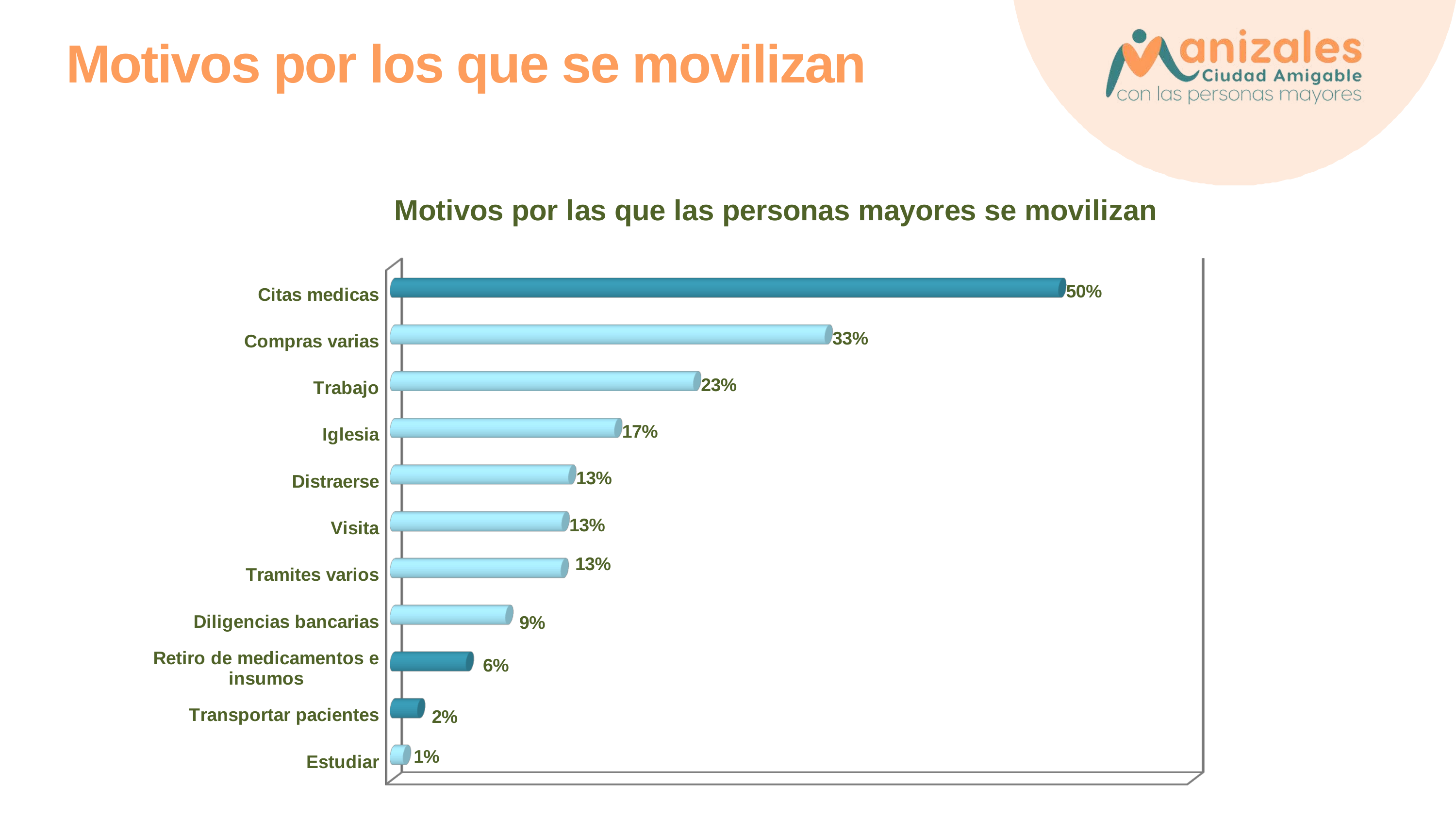
What is the value for Iglesia? 17% What is the value for Compras varias? 33% Which is larger, the value for Trabajo or the value for Diligencias bancarias? Trabajo What is the difference between the values for Citas medicas and Compras varias? 17% What is the value for Retiro de medicamentos e insumos? 6% Which category has the highest value? Citas medicas What is the value for Citas medicas? 50% What kind of chart is shown on the slide? Bar chart What is the value for Diligencias bancarias? 9% How many categories are shown in the chart? 11 Which category has the lowest value? Estudiar What is the difference between the values for Trabajo and Iglesia? 6%